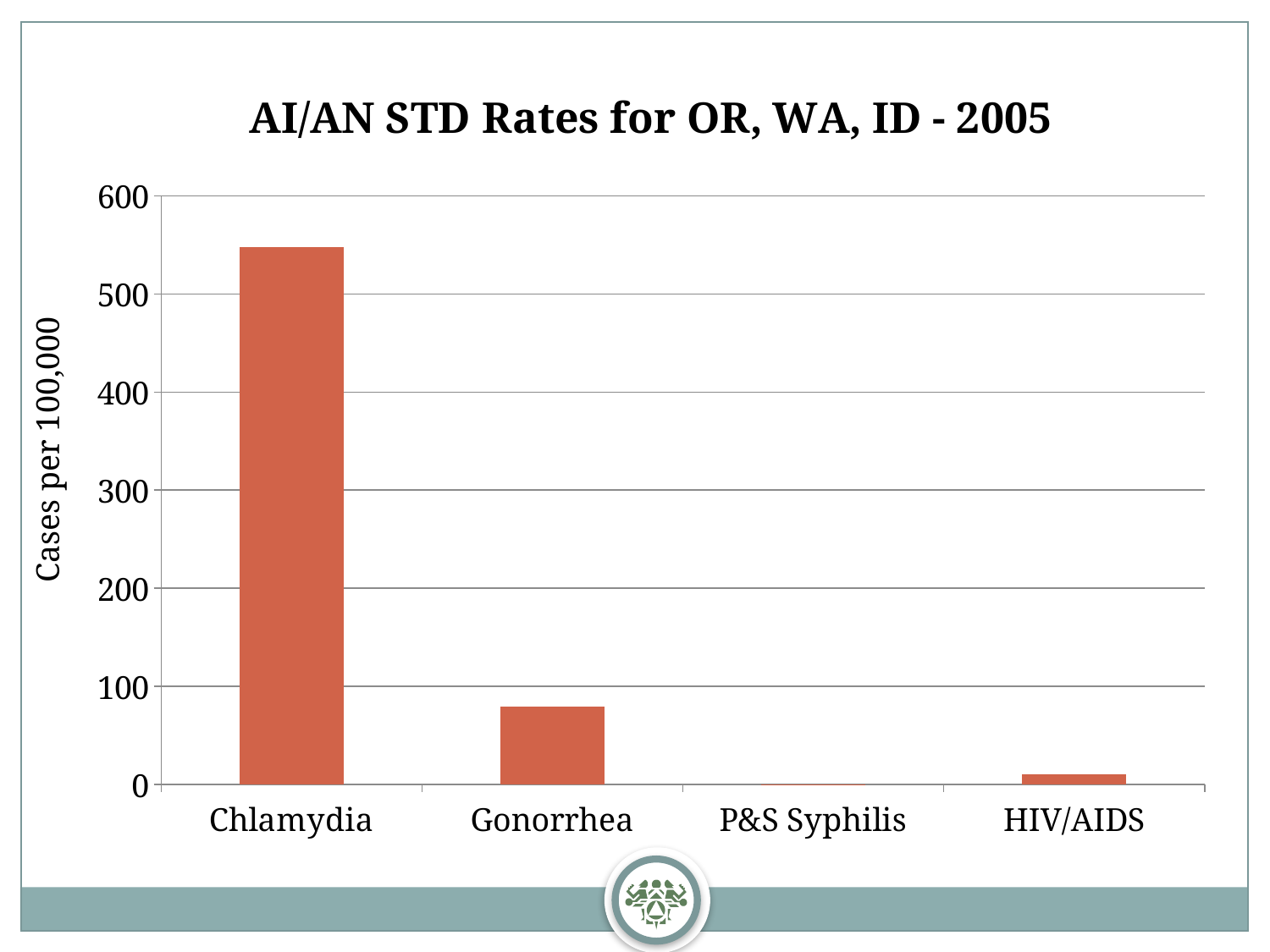
What is the highest tick value shown on the vertical axis? 600 Which category has the lowest rate? P&S Syphilis Is the value for Chlamydia greater or less than 500? greater Which category has the highest rate? Chlamydia What type of chart is shown on the slide? bar chart Is the value for HIV/AIDS greater or less than 100? less How many categories are shown on the x axis? 4 Is the value for Gonorrhea greater or less than 100? less Which is larger, the value for Gonorrhea or the value for HIV/AIDS? Gonorrhea Which is larger, the value for Chlamydia or the value for Gonorrhea? Chlamydia What is the label of the vertical axis? Cases per 100,000 What is the title of the chart? AI/AN STD Rates for OR, WA, ID - 2005